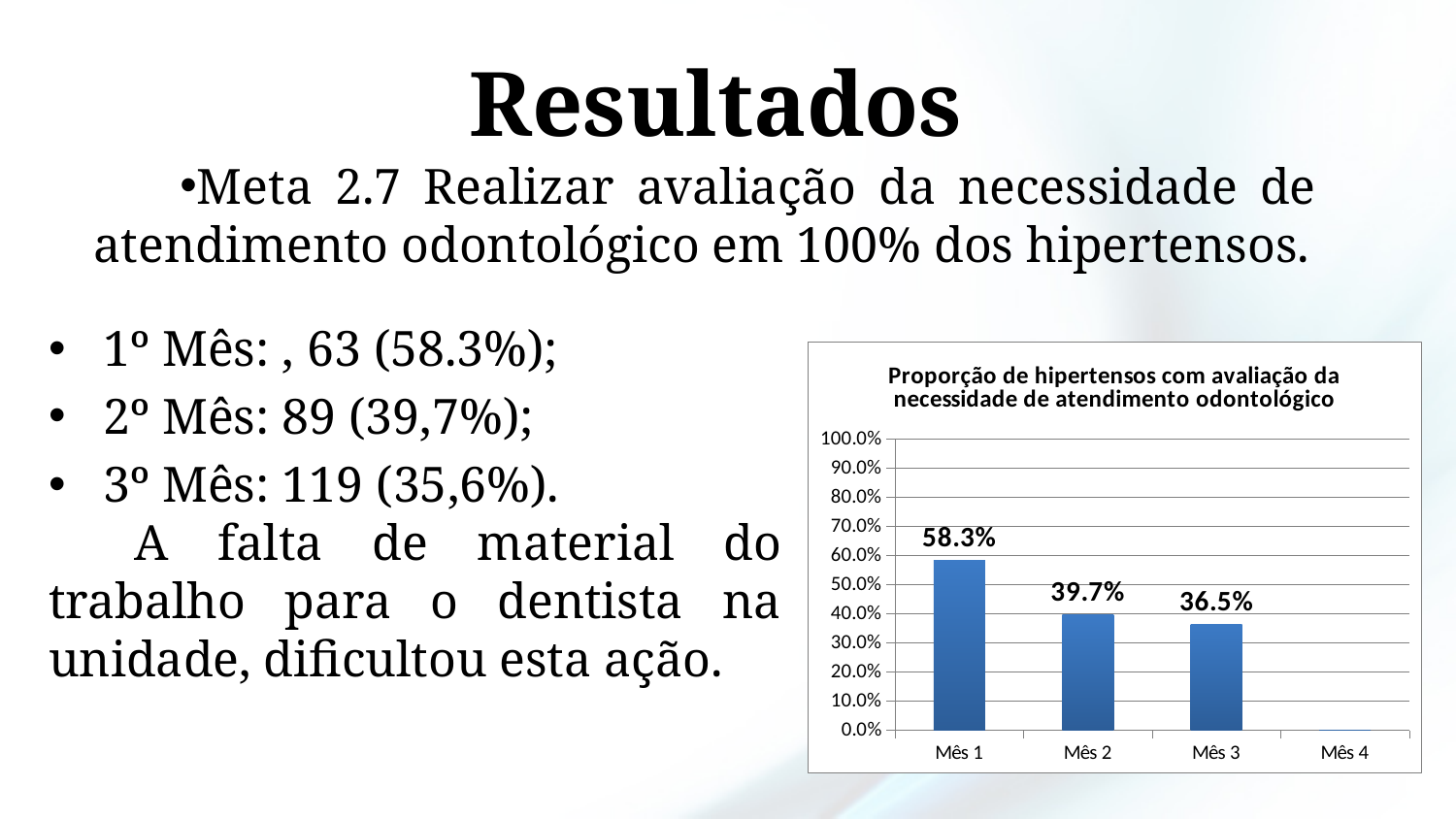
What is the value for Mês 2 in the chart? 39.7% How many month categories are shown on the x axis of the chart? 4 Is the value for Mês 3 greater or less than 40.0%? less Do the values rise or fall from Mês 1 to Mês 3? Fall Which month has the highest value in the chart? Mês 1 What is the difference between the values for Mês 2 and Mês 3? 3.2 percentage points Which is larger, the value for Mês 2 or the value for Mês 3? Mês 2 What type of chart is shown on the slide? Bar chart What is the value for Mês 3 in the chart? 36.5% Is the value for Mês 1 greater or less than 50.0%? greater What is the value for Mês 1 in the chart? 58.3% What is the difference between the values for Mês 1 and Mês 2? 18.6 percentage points